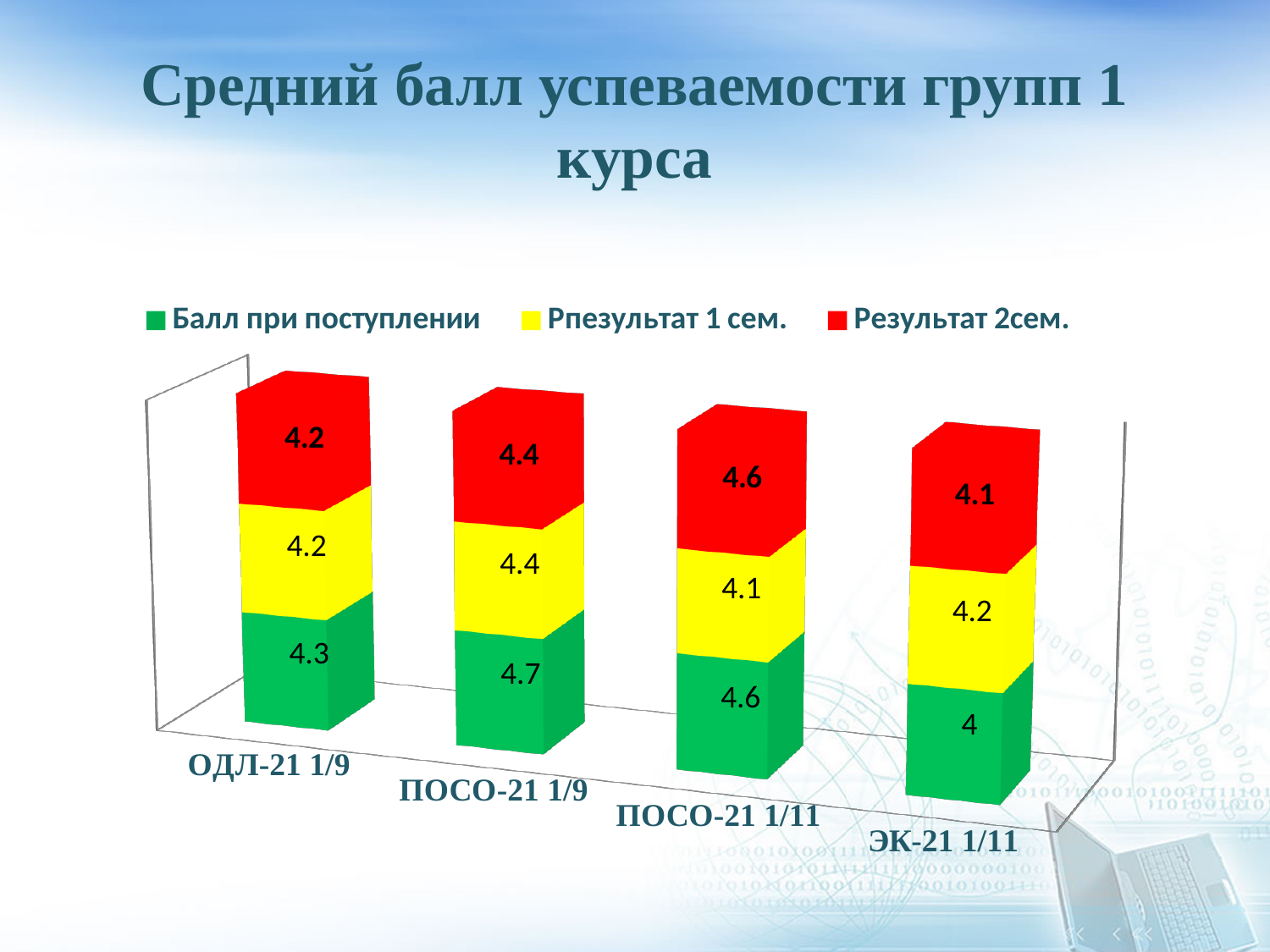
Which is larger: 'Результат 2сем.' for ПОСО-21 1/11 or for ОДЛ-21 1/9? ПОСО-21 1/11 What is the value of 'Балл при поступлении' for ПОСО-21 1/9? 4.7 How many series does the legend list? 3 What is the value of 'Балл при поступлении' for ЭК-21 1/11? 4 What is the value of 'Рпезультат 1 сем.' for ЭК-21 1/11? 4.2 How many groups are shown on the x axis? 4 What is the total of the stacked bar for ОДЛ-21 1/9? 12.7 Which group has the highest 'Балл при поступлении'? ПОСО-21 1/9 What is the difference between 'Балл при поступлении' for ПОСО-21 1/9 and for ЭК-21 1/11? 0.7 What is the value of 'Результат 2сем.' for ПОСО-21 1/11? 4.6 What kind of chart is shown on the slide? Stacked bar chart Which group has the lowest 'Результат 2сем.'? ЭК-21 1/11